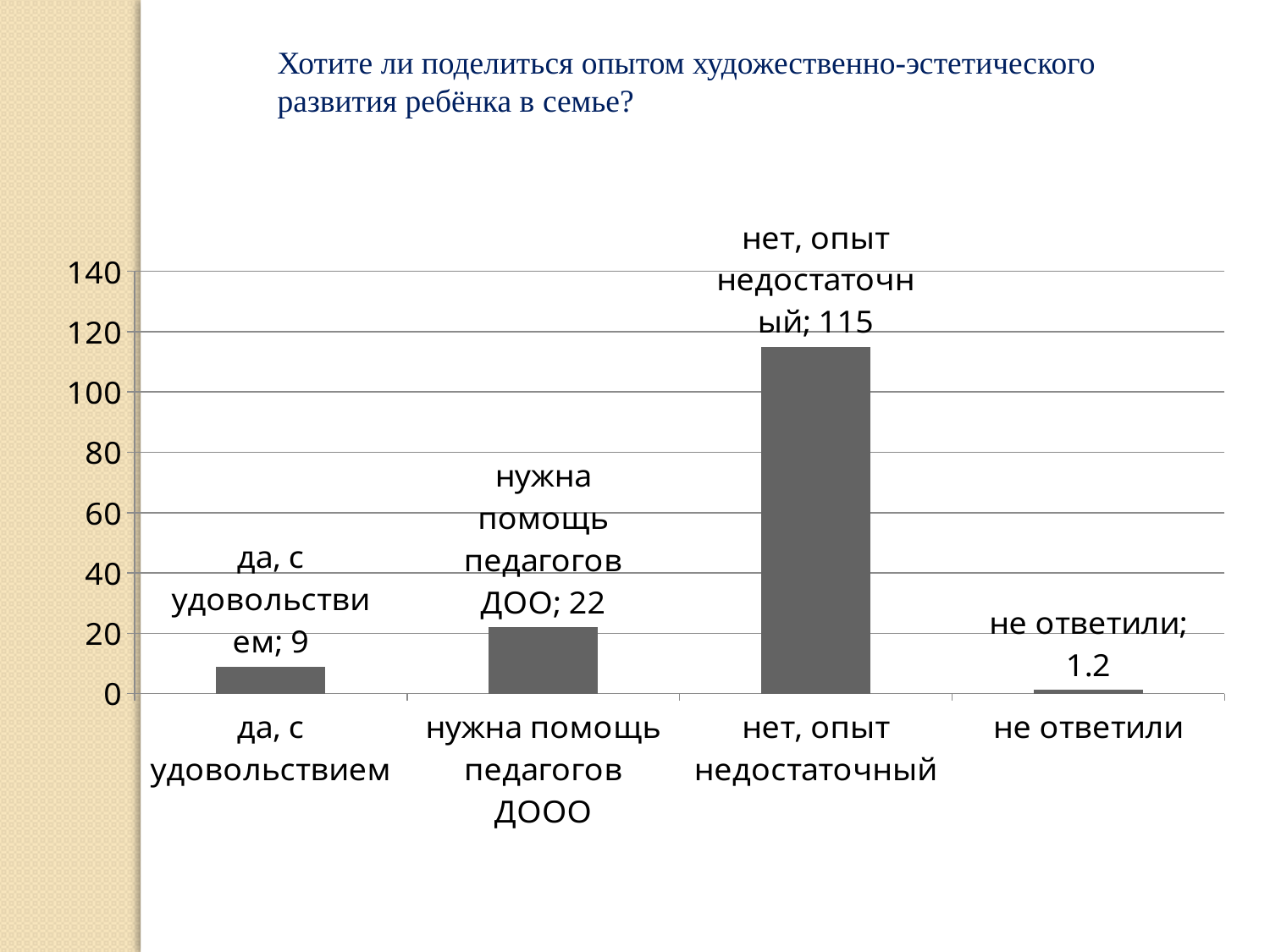
Which is larger: the value for "нужна помощь педагогов ДООО" or the value for "да, с удовольствием"? нужна помощь педагогов ДООО What is the value for "да, с удовольствием"? 9 How many categories are shown in the chart? 4 What is the value for "нет, опыт недостаточный"? 115 What is the value for "нужна помощь педагогов ДООО"? 22 What is the value for "не ответили"? 1.2 Which category has the lowest value? не ответили What is the title of the chart? Хотите ли поделиться опытом художественно-эстетического развития ребёнка в семье? What is the difference between the values for "нет, опыт недостаточный" and "нужна помощь педагогов ДООО"? 93 Which category has the highest value? нет, опыт недостаточный Is the value for "нет, опыт недостаточный" greater or less than 100? greater What kind of chart is shown on the slide? bar chart